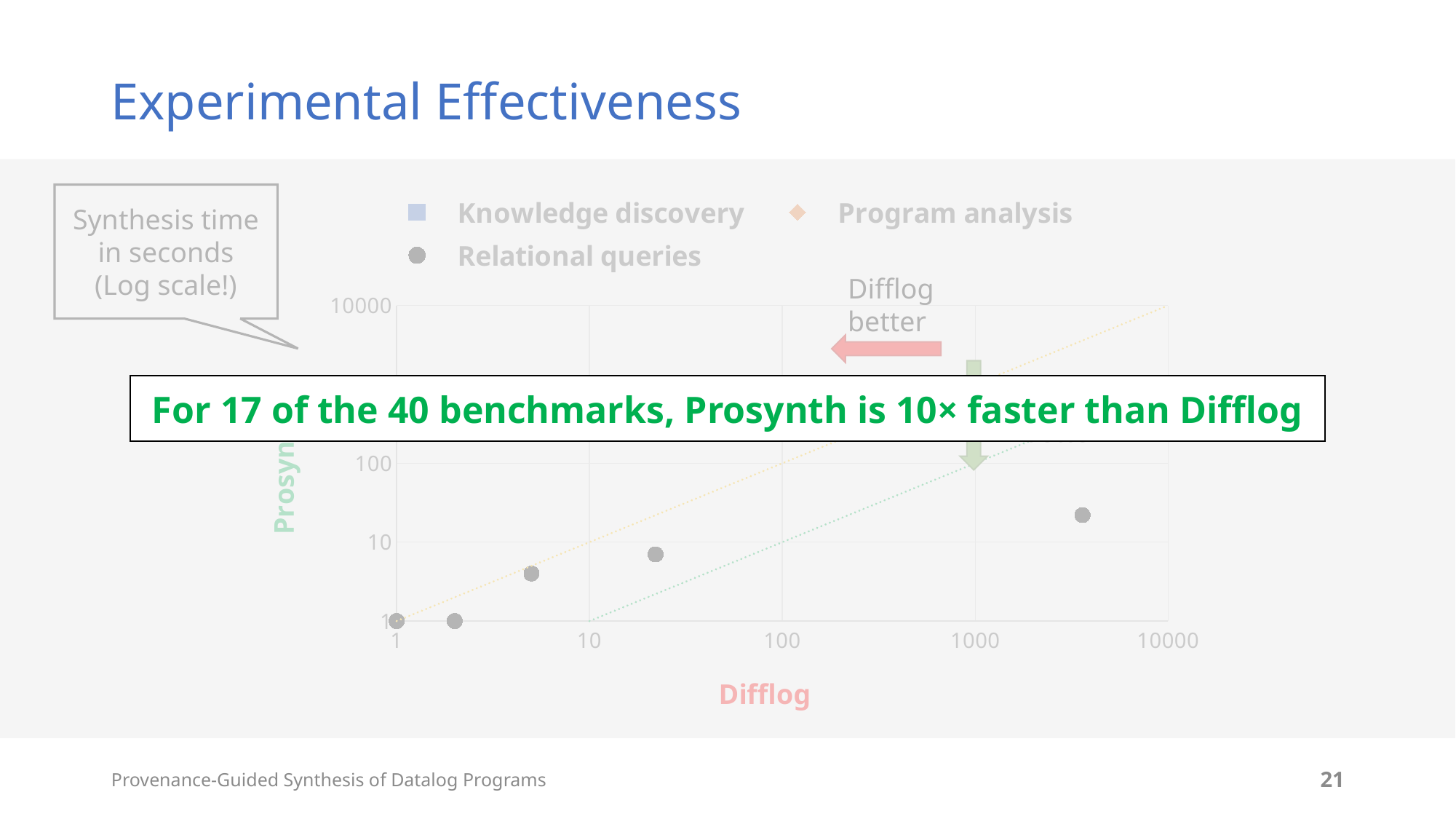
What is the label of the chart's x axis? Difflog Is the Prosynth value for the rightmost Relational queries point greater or less than 10? greater What is the highest tick value shown on the chart's x axis? 10000 Which series are listed in the chart's legend? Knowledge discovery, Program analysis, Relational queries Is the Prosynth value for the Relational queries point with a Difflog value between 10 and 100 greater or less than 10? less Is the Prosynth value for the Relational queries point with a Difflog value between 1 and 10 greater or less than 10? less How many series does the chart's legend list? 3 Which has the larger Prosynth value: the rightmost Relational queries point or the Relational queries point with a Difflog value between 10 and 100? the rightmost point What kind of chart is shown on the slide? scatter chart What is the lowest tick value shown on the chart's y axis? 1